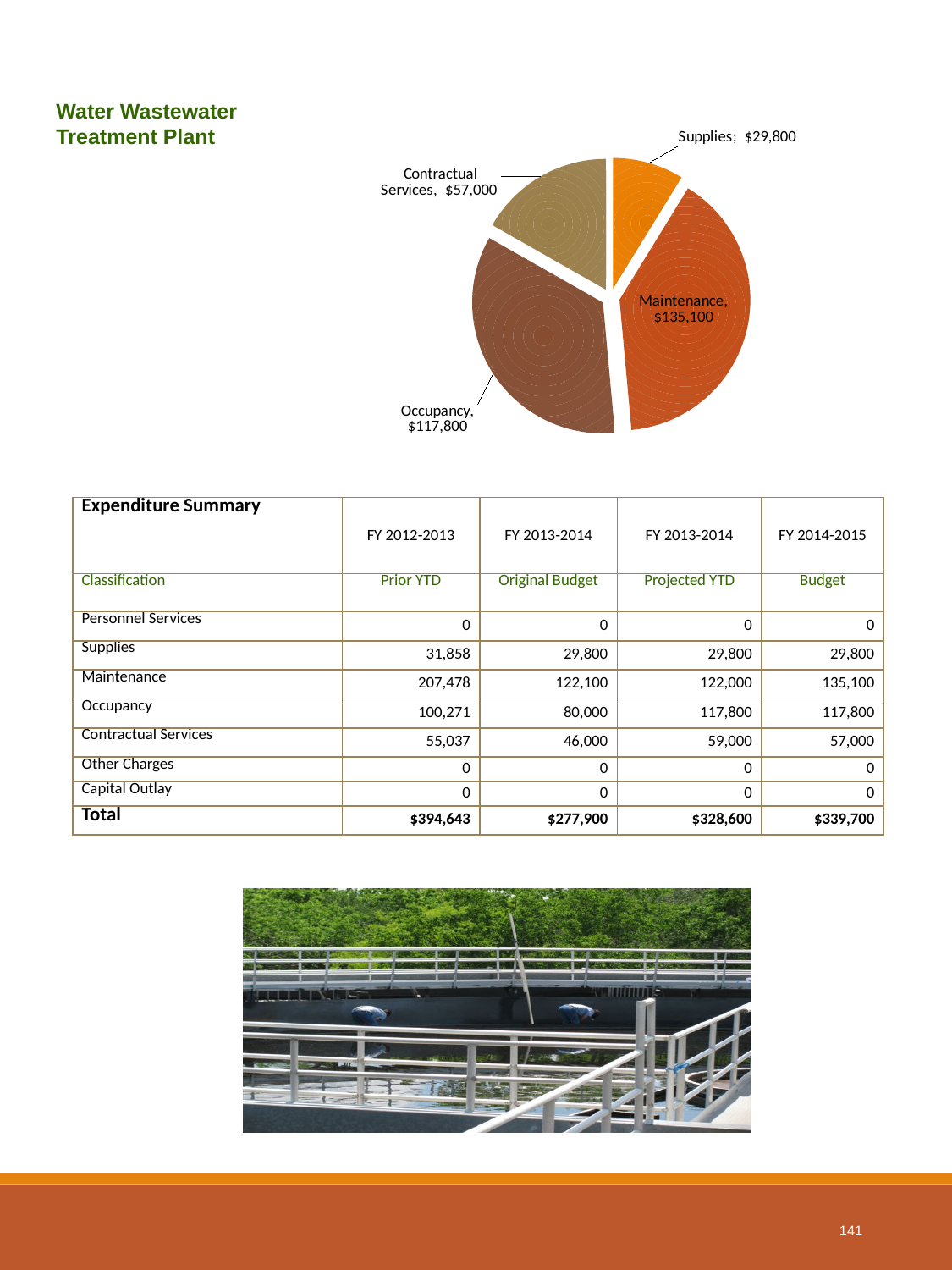
Which category has the smallest slice in the pie chart? Supplies What is the difference between the Maintenance and Occupancy values in the pie chart? $17,300 Which is larger in the pie chart, Contractual Services or Supplies? Contractual Services What is the value of the Occupancy slice in the pie chart? $117,800 What is the title shown at the top left of the slide above the pie chart? Water Wastewater Treatment Plant What type of chart is shown on the slide? Pie chart Which category has the largest slice in the pie chart? Maintenance What is the value of the Supplies slice in the pie chart? $29,800 What is the value of the Contractual Services slice in the pie chart? $57,000 What is the total of all four slices in the pie chart? $339,700 What is the value of the Maintenance slice in the pie chart? $135,100 How many slices does the pie chart have? 4